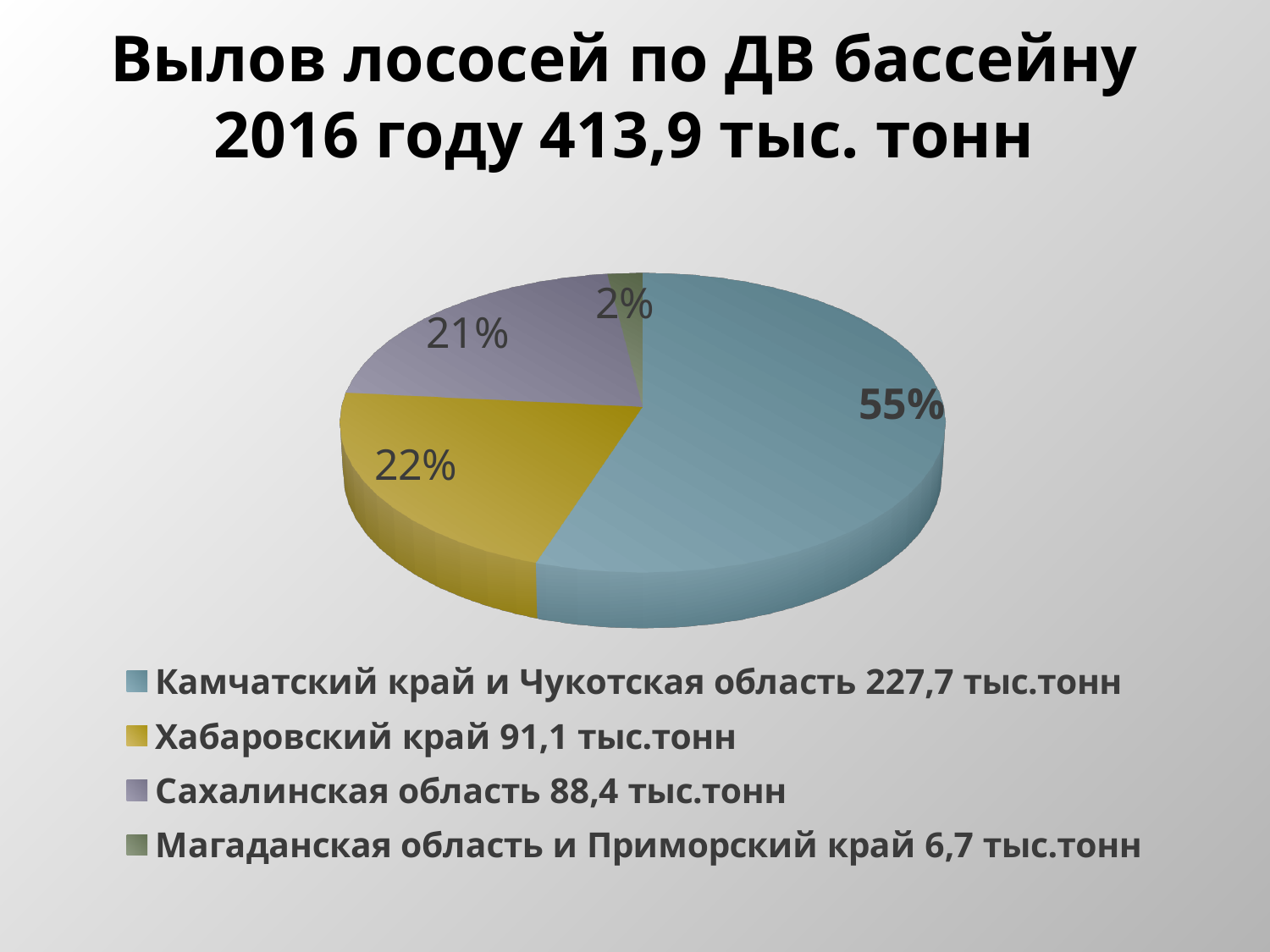
What share of the pie does the Магаданская область и Приморский край slice represent? 2% What is the title of the chart on the slide? Вылов лососей по ДВ бассейну 2016 году 413,9 тыс. тонн Which category has the largest slice of the pie? Камчатский край и Чукотская область What share of the pie does the Камчатский край и Чукотская область slice represent? 55% How many slices does the pie chart have? 4 Which slice is larger: Хабаровский край or Сахалинская область? Хабаровский край What is the difference in percentage points between the Камчатский край и Чукотская область slice and the Хабаровский край slice? 33 percentage points Which category has the smallest slice of the pie? Магаданская область и Приморский край What share of the pie does the Хабаровский край slice represent? 22% What colour is the Хабаровский край slice in the pie chart? Yellow What kind of chart is shown on the slide? Pie chart